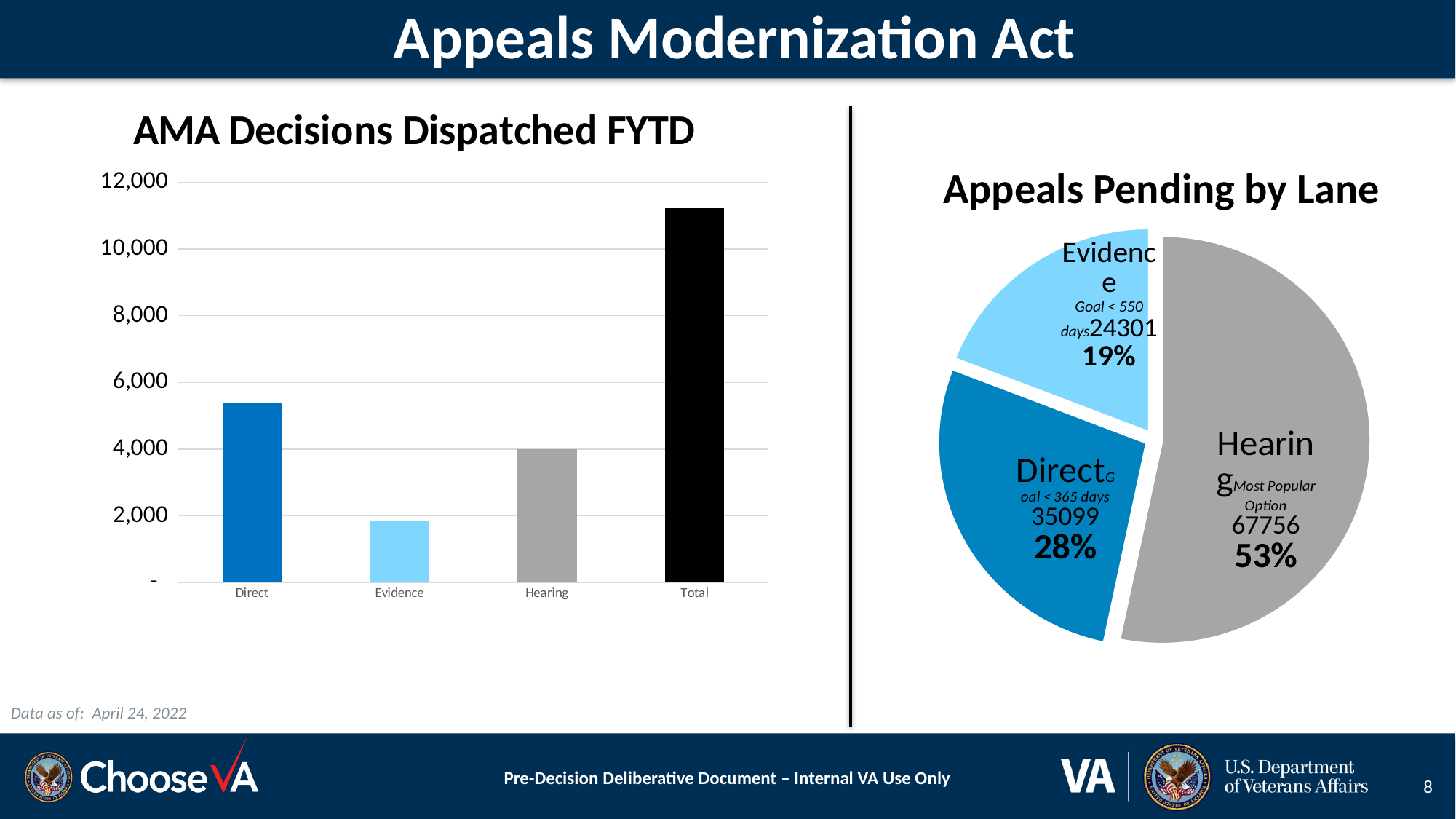
In the 'AMA Decisions Dispatched FYTD' chart, which category has the shortest bar? Evidence In the 'Appeals Pending by Lane' chart, how many appeals are pending in the Hearing lane? 67756 In the 'Appeals Pending by Lane' chart, which lane has the smallest slice? Evidence What kind of chart is the 'AMA Decisions Dispatched FYTD' chart? bar chart In the 'AMA Decisions Dispatched FYTD' chart, which is larger, Direct or Hearing? Direct In the 'AMA Decisions Dispatched FYTD' chart, which category has the tallest bar? Total In the 'Appeals Pending by Lane' chart, what share of the pie is the Direct lane? 28% In the 'Appeals Pending by Lane' chart, how many more appeals are pending in the Hearing lane than in the Direct lane? 32657 What kind of chart is the 'Appeals Pending by Lane' chart? pie chart In the 'AMA Decisions Dispatched FYTD' chart, is the value for Direct greater or less than 4,000? greater In the 'AMA Decisions Dispatched FYTD' chart, how many categories are shown on the x axis? 4